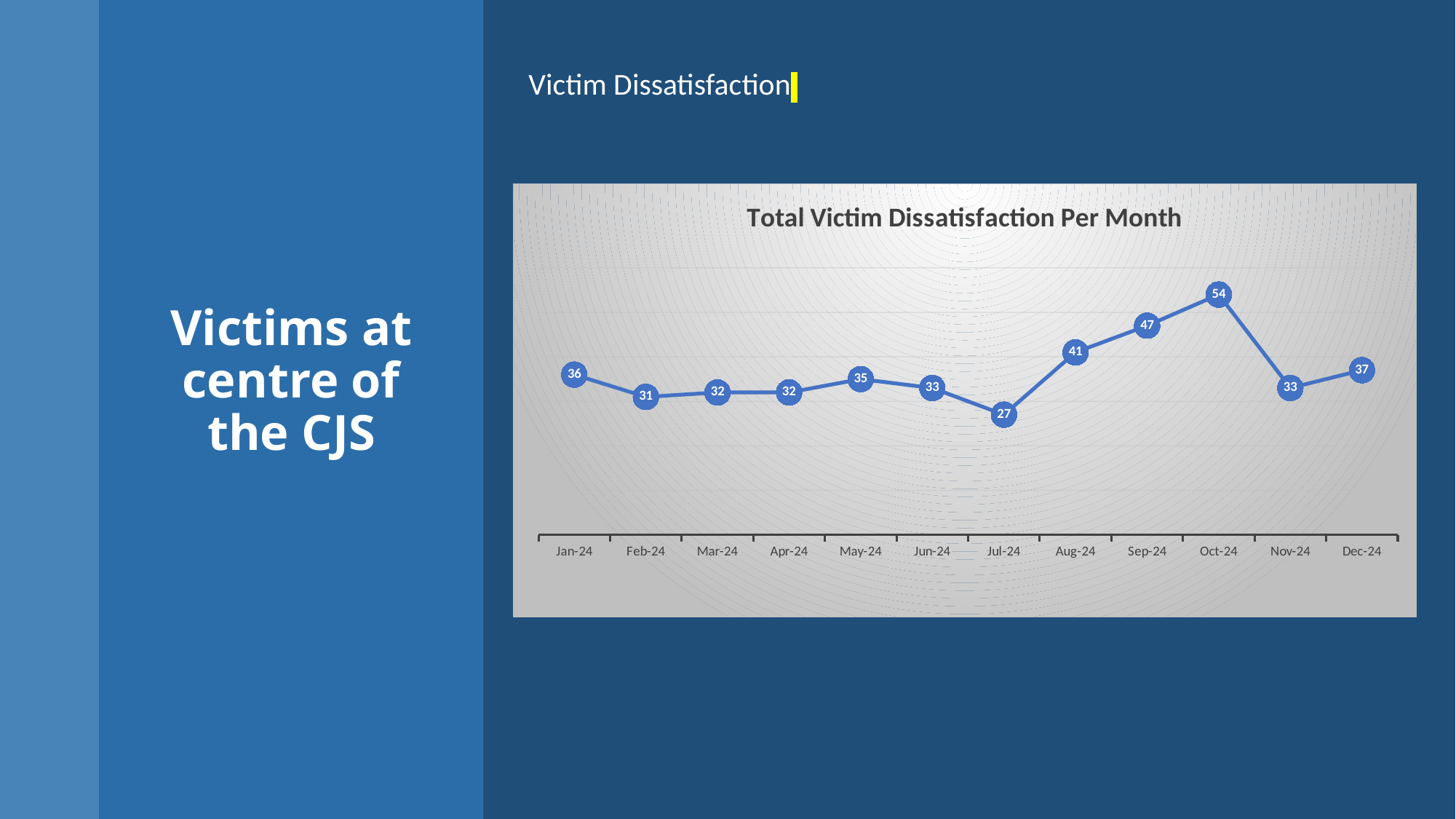
Which month has the lowest value? Jul-24 How many months are plotted on the chart? 12 What is the value for Jul-24? 27 What is the title of the chart? Total Victim Dissatisfaction Per Month What is the difference between the values for Oct-24 and Nov-24? 21 What is the difference between the values for Aug-24 and Jul-24? 14 What is the value for Oct-24? 54 Do the values rise or fall from Jul-24 to Oct-24? Rise What is the value for Jan-24? 36 What kind of chart is shown? Line chart Which month has the highest value? Oct-24 Which is larger, the value for Sep-24 or the value for Dec-24? Sep-24